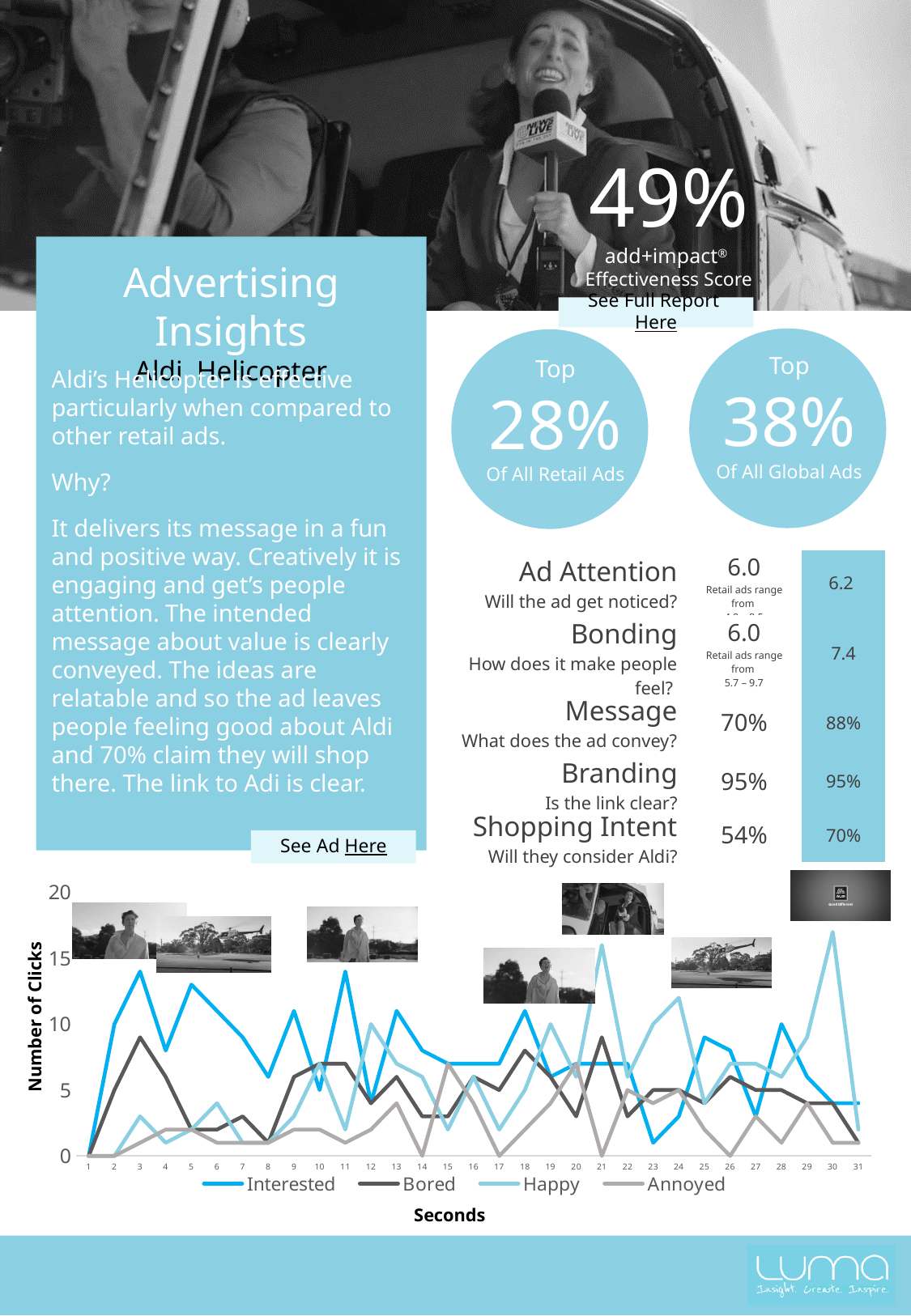
What kind of chart is shown at the bottom of the slide? Line chart In the line chart, is the value for Interested at second 3 greater or less than 10? greater In the line chart, which series reaches the highest number of clicks at any second? Happy In the line chart, is the value for Happy at second 30 greater or less than 15? greater In the line chart, at second 30, which is larger: Happy or Interested? Happy How many series does the legend of the line chart list? 4 What are the four series named in the legend of the line chart? Interested, Bored, Happy, Annoyed In the line chart, at second 3, which is larger: Interested or Bored? Interested How many seconds (points) are marked along the x axis of the line chart? 31 In the line chart, is the value for Annoyed at second 14 greater or less than 5? less What is the title of the vertical axis of the line chart? Number of Clicks